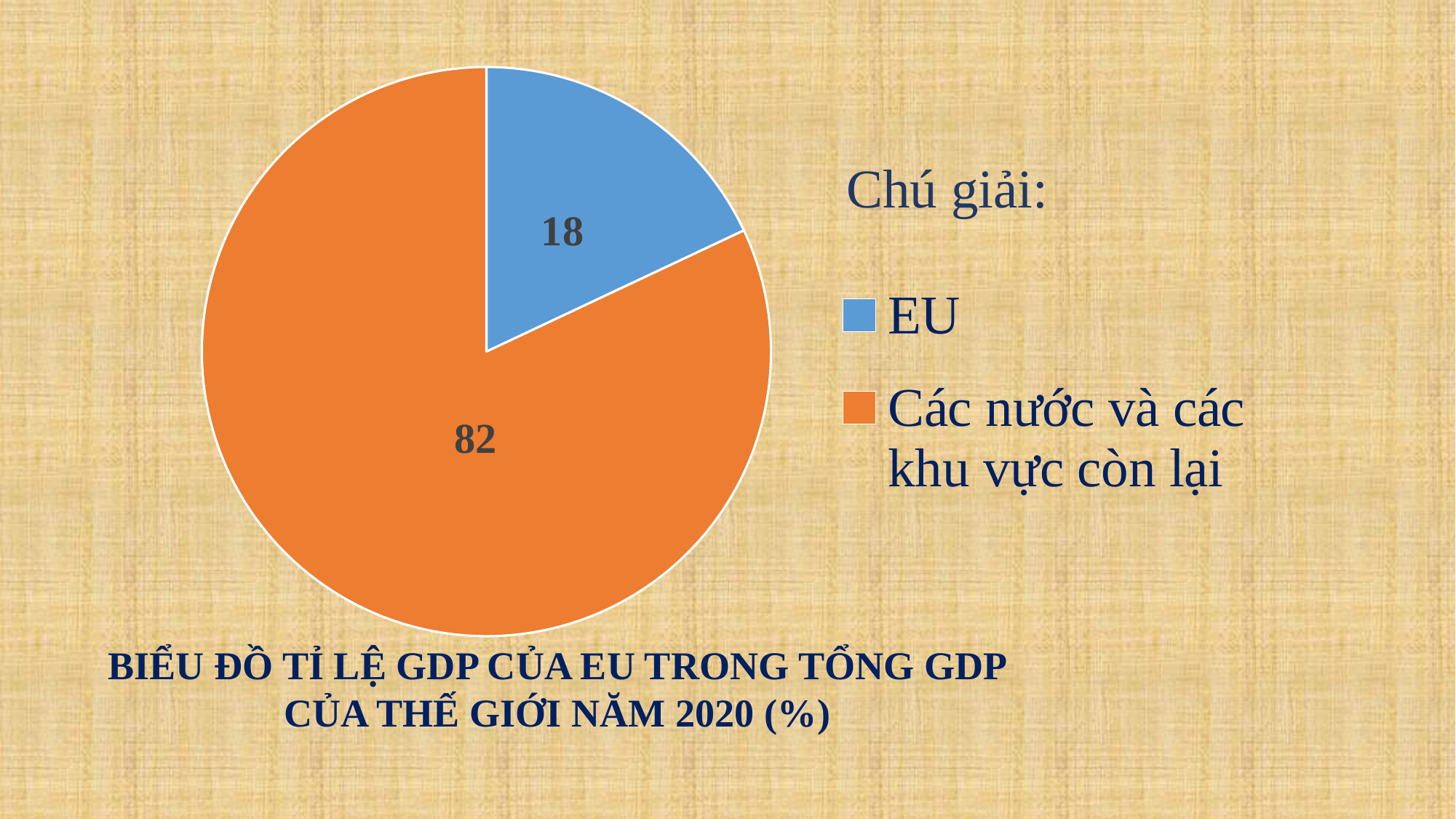
What is the value shown for Các nước và các khu vực còn lại? 82 How many entries does the legend list? 2 Which is larger, the value for EU or the value for Các nước và các khu vực còn lại? Các nước và các khu vực còn lại What is the difference between the value for Các nước và các khu vực còn lại and the value for EU? 64 Which slice is the smallest? EU Which slice is the largest? Các nước và các khu vực còn lại What is the value shown for EU? 18 What type of chart is shown on the slide? pie chart What is the title of the chart? BIỂU ĐỒ TỈ LỆ GDP CỦA EU TRONG TỔNG GDP CỦA THẾ GIỚI NĂM 2020 (%) What share of the pie does the EU slice represent? 18% How many slices does the pie chart have? 2 What colour is the EU slice? blue